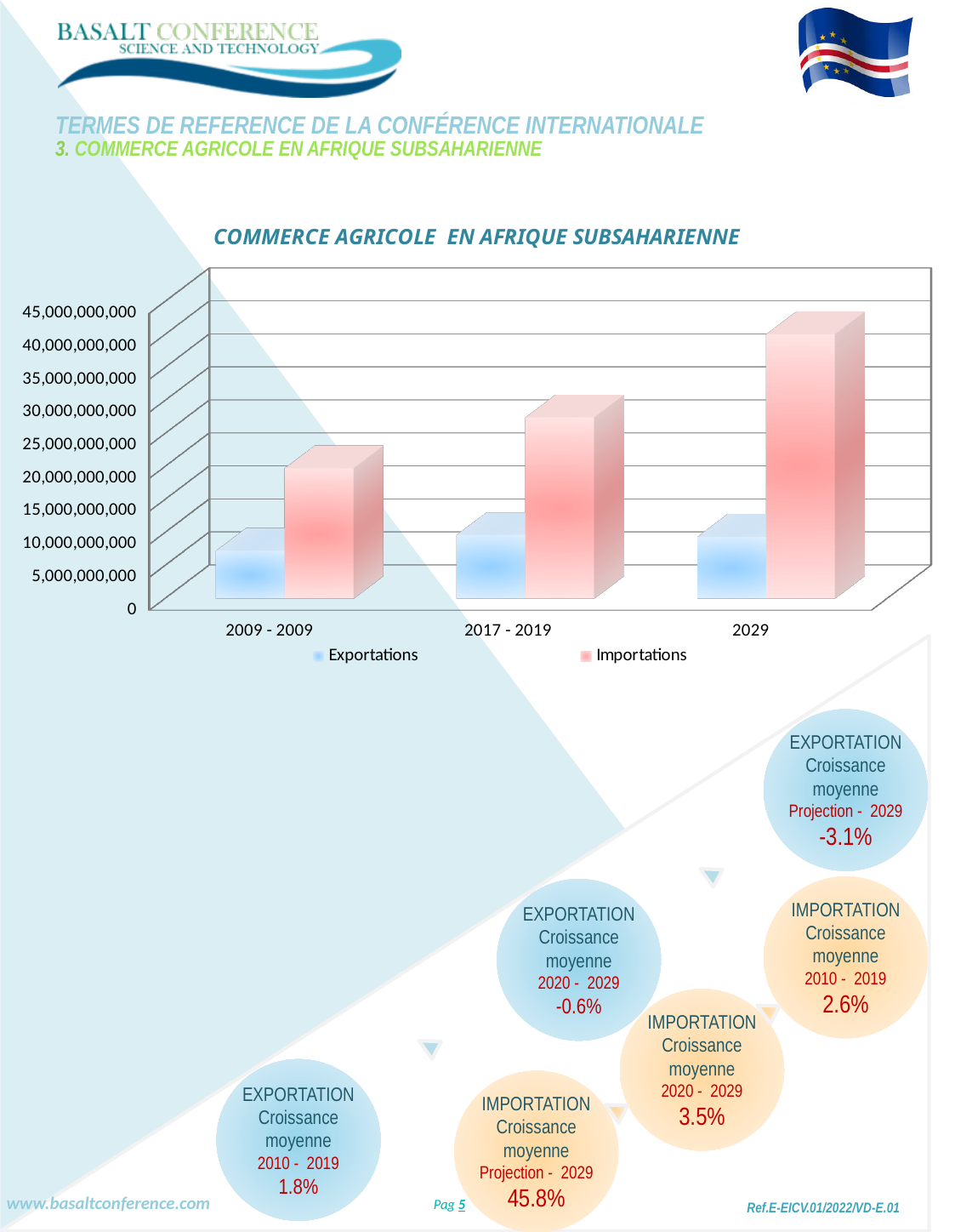
Is the Importations value for 2017 - 2019 greater or less than 20,000,000,000? greater What kind of chart is shown on the slide? bar chart For which category is the Importations value highest? 2029 How many series does the chart legend list? 2 For which category is the Importations value lowest? 2009 - 2009 How many categories are shown on the x axis of the chart? 3 In 2029, which is larger, Exportations or Importations? Importations What is the title of the chart? COMMERCE AGRICOLE EN AFRIQUE SUBSAHARIENNE Do the Importations values rise or fall across the categories from 2009 - 2009 to 2029? rise Which series is shown in red/pink in the chart? Importations Is the Importations value for 2029 greater or less than 35,000,000,000? greater Is the Exportations value for 2009 - 2009 greater or less than 10,000,000,000? less